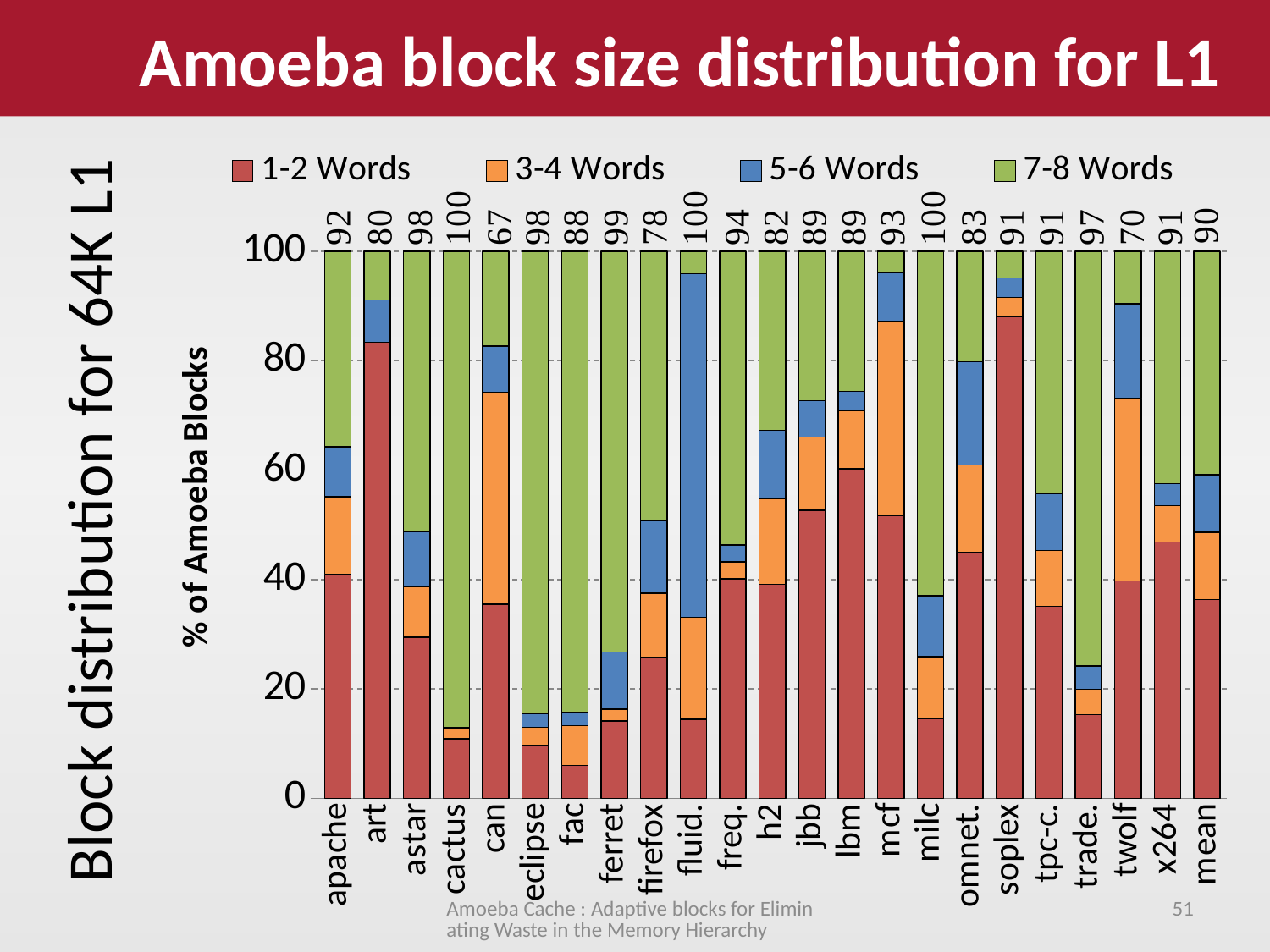
How many categories are shown along the x axis? 23 Is the 1-2 Words segment larger for apache or for astar? apache How many series does the legend list? 4 Is the 1-2 Words value for art greater or less than 80? greater Which category has the lowest number printed above its bar? can Which category has the smallest 1-2 Words segment? fac What is the label of the y axis? % of Amoeba Blocks What number is printed above the bar for mean? 90 What number is printed above the bar for can? 67 What is the difference between the numbers printed above the bars for cactus and can? 33 What number is printed above the bar for cactus? 100 What kind of chart is shown on the slide? stacked bar chart